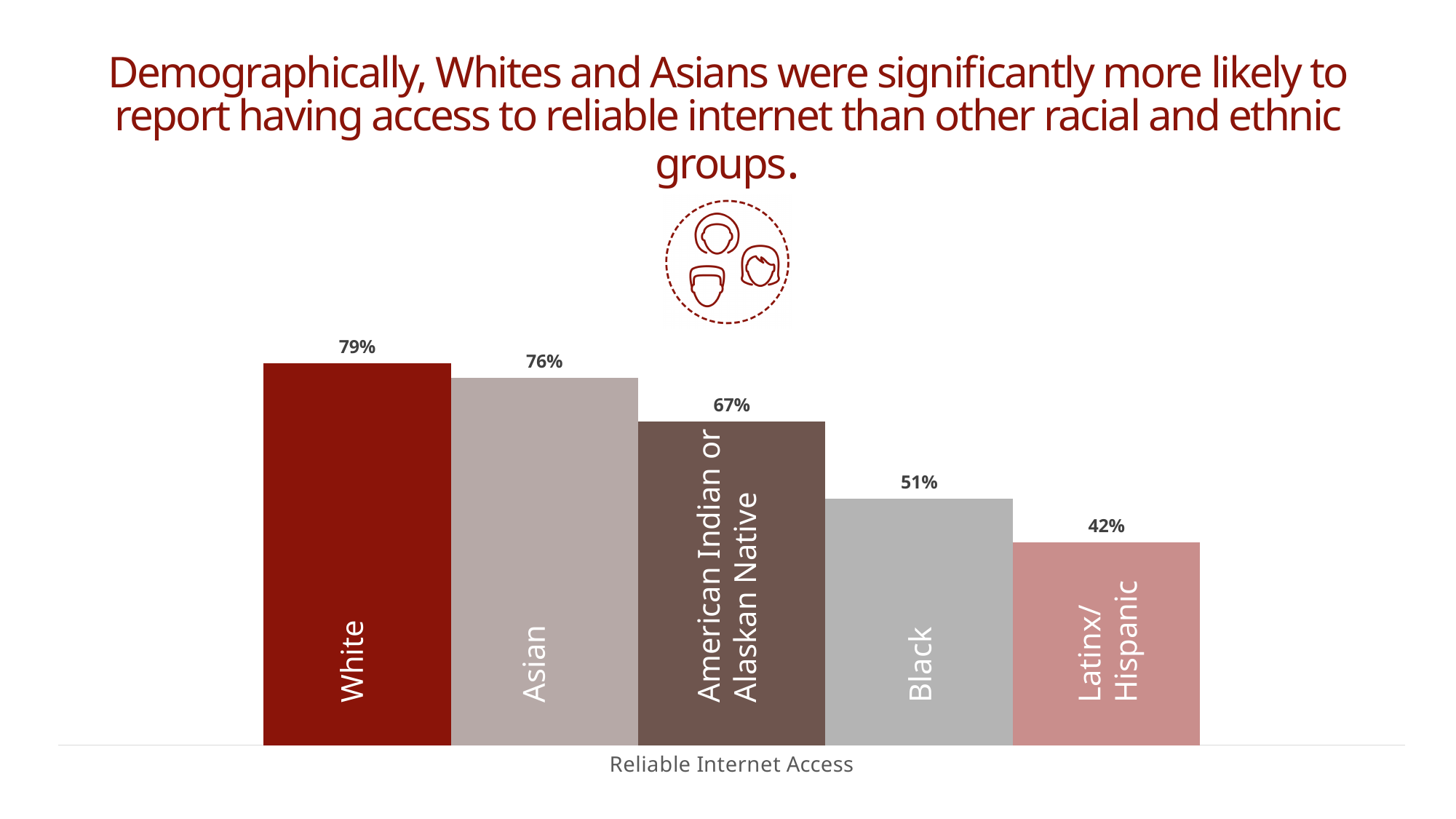
What is the difference in percentage points between White and Latinx/Hispanic respondents? 37 What type of chart is shown on the slide? Bar chart What is the value shown for Asian respondents? 76% What percentage is shown for Latinx/Hispanic respondents? 42% What percentage is shown for American Indian or Alaskan Native respondents? 67% How many racial or ethnic groups are shown in the chart? 5 Which group has a higher value, American Indian or Alaskan Native or Black? American Indian or Alaskan Native What percentage of White respondents reported having reliable internet access? 79% What is the value shown for Black respondents? 51% Which group has the lowest reported reliable internet access? Latinx/Hispanic What is the difference in percentage points between Asian and Black respondents? 25 Which group has the highest reported reliable internet access? White